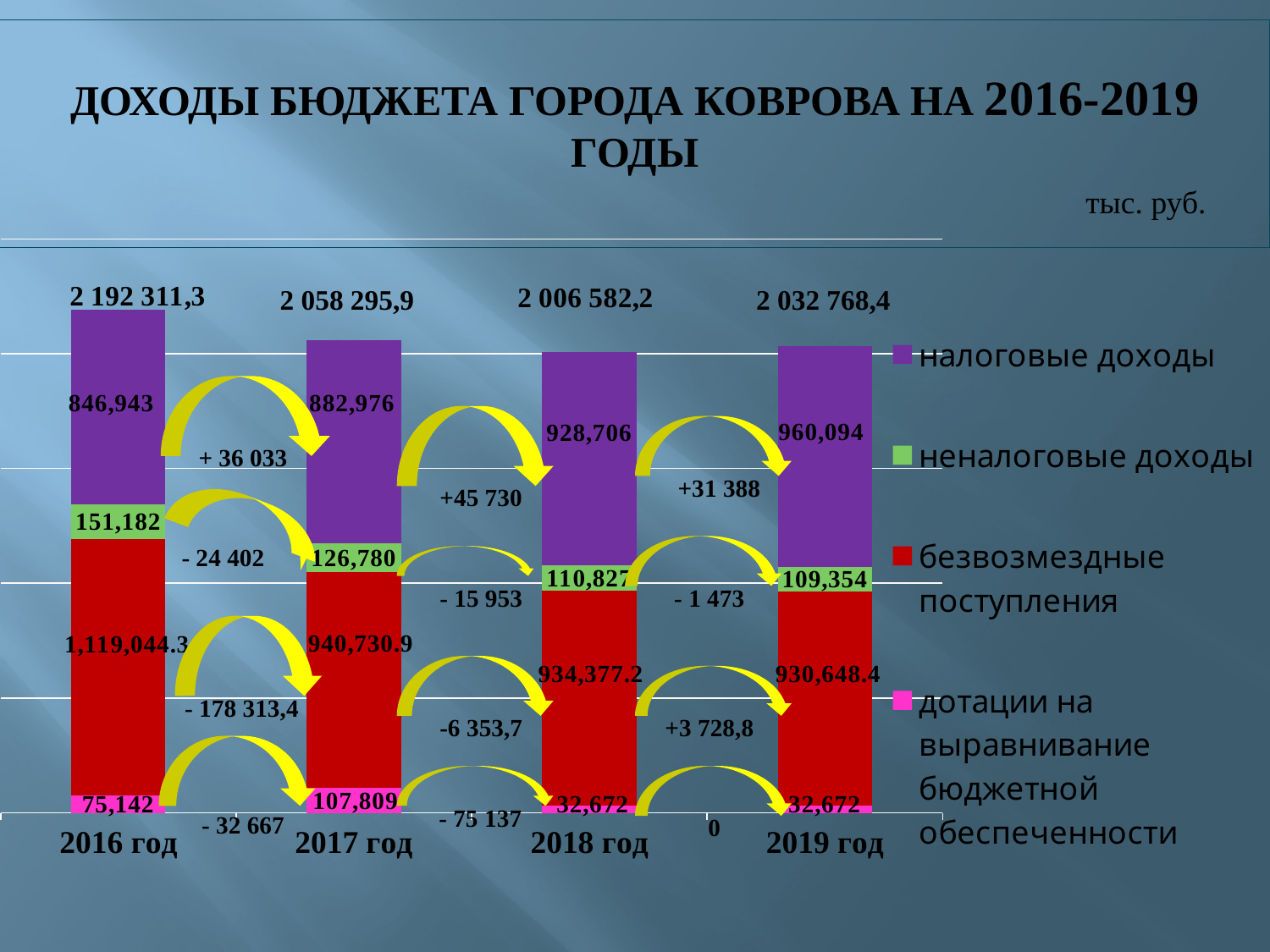
Do the values of налоговые доходы rise or fall from 2016 to 2019? rise What type of chart is shown on the slide? stacked bar chart How many series does the legend list? 4 What unit of measurement is indicated on the slide for the chart values? тыс. руб. How many years (categories) are shown on the x axis? 4 What is the value of налоговые доходы for 2018 год? 928,706 Which is larger: безвозмездные поступления in 2016 год or in 2017 год? 2016 год What is the total budget revenue shown above the bar for 2017 год? 2 058 295,9 What is the value of неналоговые доходы for 2016 год? 151,182 What is the value of безвозмездные поступления for 2019 год? 930,648.4 In which year is the value of дотации на выравнивание бюджетной обеспеченности the highest? 2017 год In which year is the value of налоговые доходы the highest? 2019 год